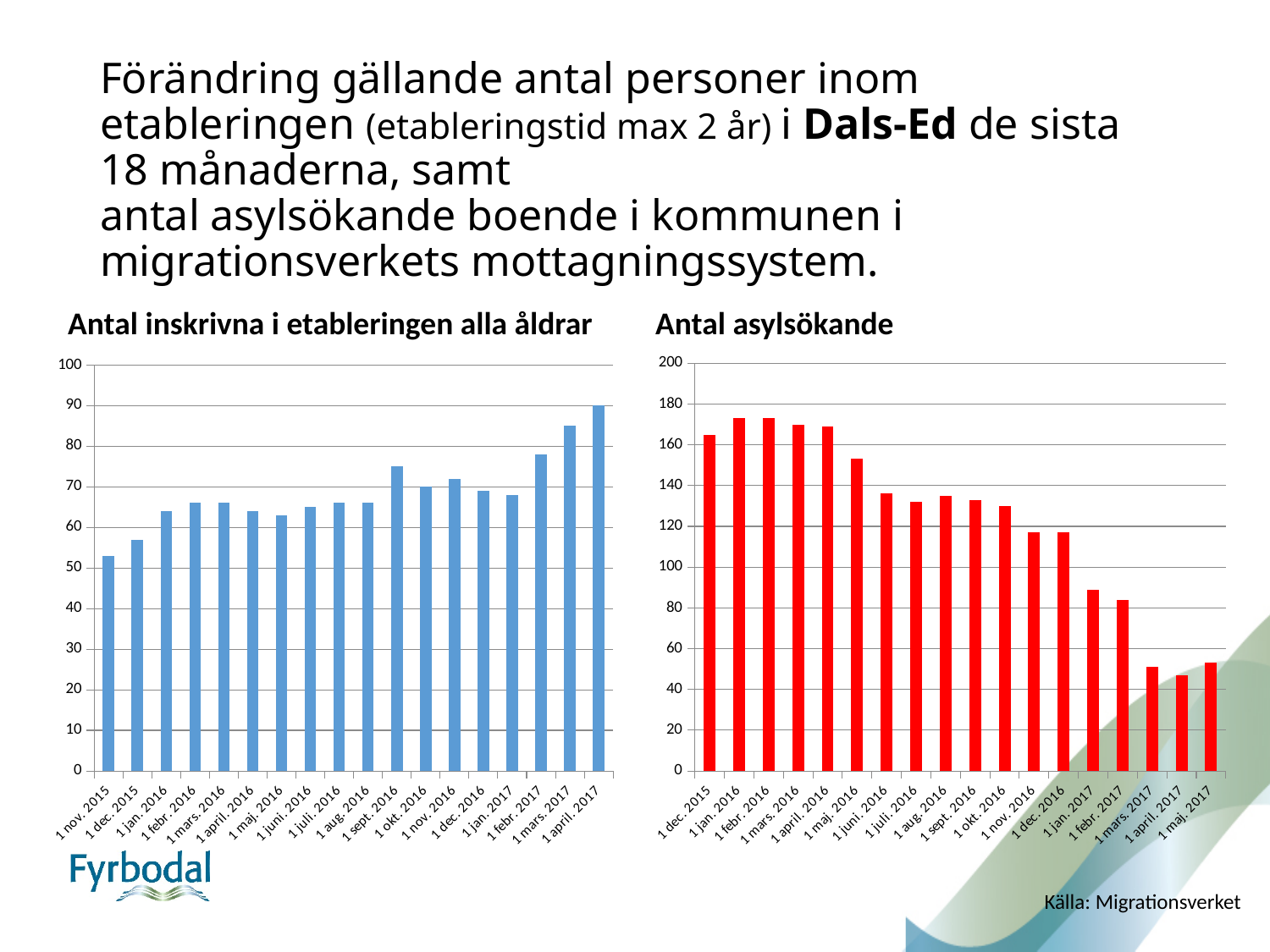
How many bars (months) are shown in the 'Antal asylsökande' chart? 18 In the 'Antal inskrivna i etableringen alla åldrar' chart, which month has the highest value? 1 april. 2017 In the 'Antal asylsökande' chart, which is larger, the value for 1 okt. 2016 or 1 nov. 2016? 1 okt. 2016 In the 'Antal asylsökande' chart, do the values generally rise or fall from left to right? fall In the 'Antal inskrivna i etableringen alla åldrar' chart, which month has the lowest value? 1 nov. 2015 In the 'Antal inskrivna i etableringen alla åldrar' chart, is the value for 1 nov. 2015 greater or less than 60? less How many bars (months) are shown in the 'Antal inskrivna i etableringen alla åldrar' chart? 18 What kind of chart is the 'Antal inskrivna i etableringen alla åldrar' chart? bar chart In the 'Antal asylsökande' chart, is the value for 1 maj. 2016 greater or less than 140? greater In the 'Antal asylsökande' chart, is the value for 1 jan. 2017 greater or less than 100? less What colour are the bars in the 'Antal asylsökande' chart? red In the 'Antal inskrivna i etableringen alla åldrar' chart, do the values generally rise or fall from left to right? rise